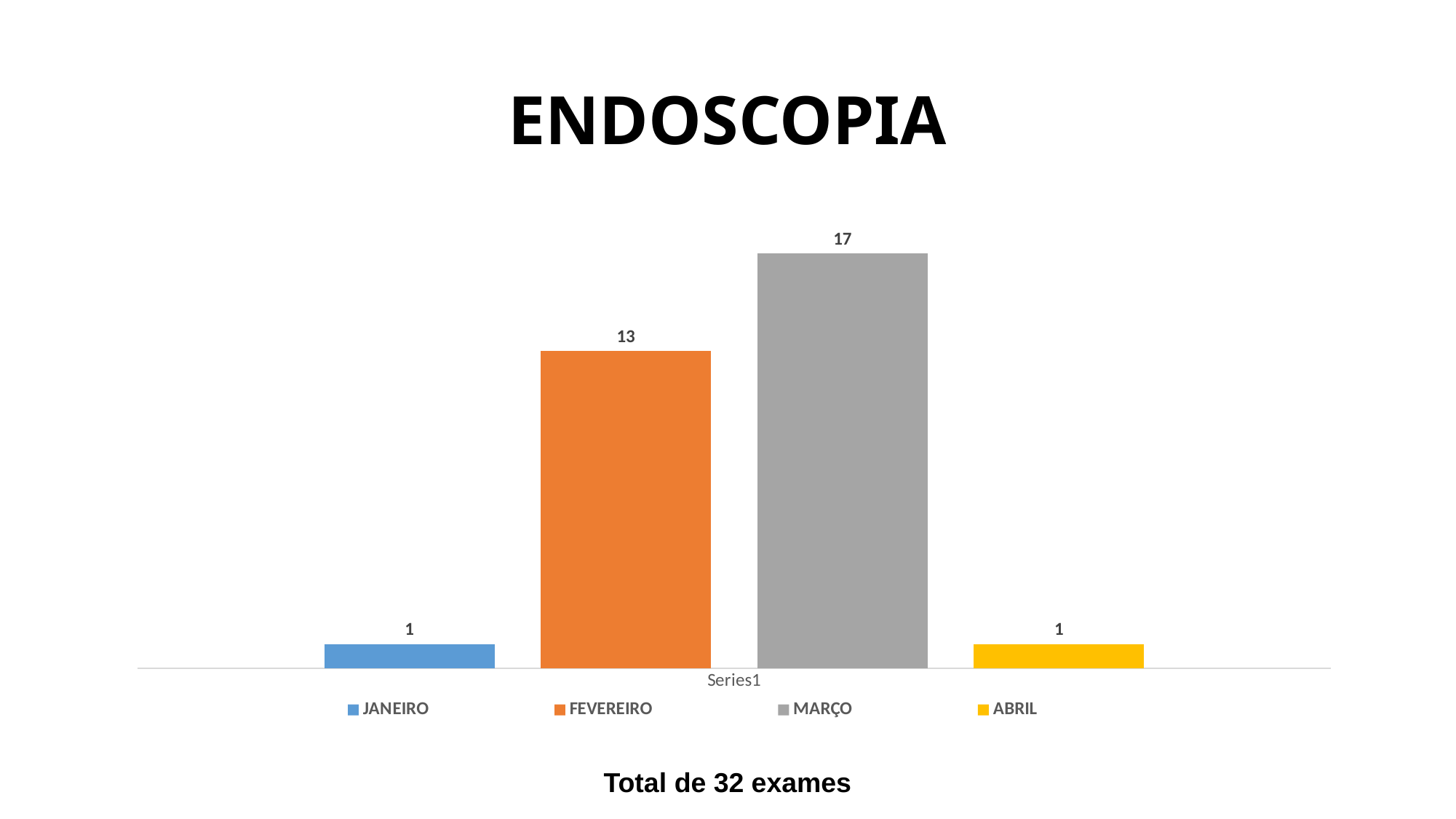
What colour is the bar for FEVEREIRO? Orange What is the value for ABRIL? 1 What is the value for MARÇO? 17 What is the value for FEVEREIRO? 13 Which month has the highest value? MARÇO What kind of chart is shown on the slide? Bar chart What is the value for JANEIRO? 1 What is the title of the slide? ENDOSCOPIA Which is larger, the value for FEVEREIRO or the value for MARÇO? MARÇO How many entries does the legend list? 4 How many bars are shown in the chart? 4 What is the difference between the values for MARÇO and FEVEREIRO? 4